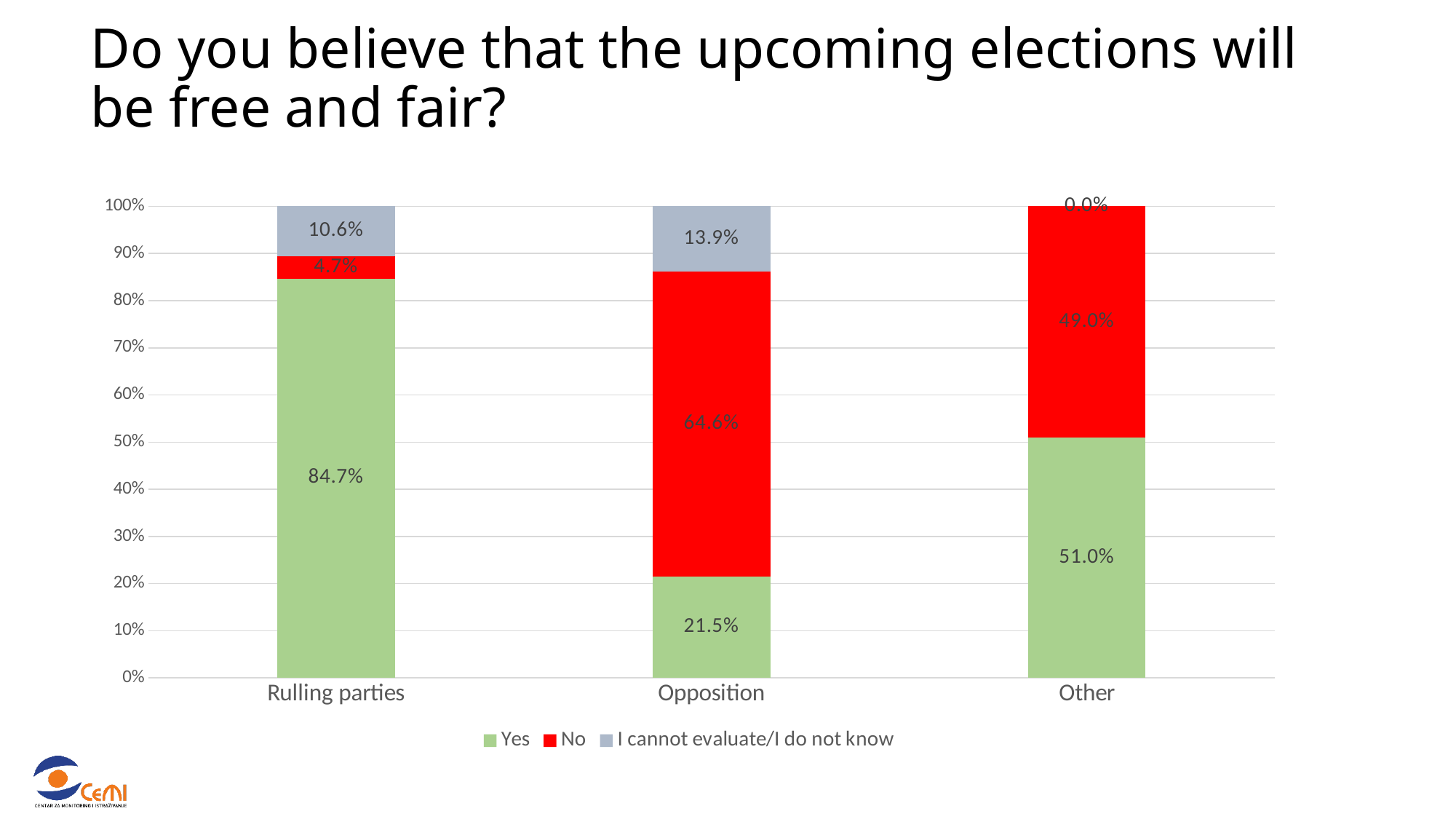
Which is larger: the No share for Opposition or the No share for Other? Opposition Which category has the lowest No share? Rulling parties What percentage of Opposition respondents answered No? 64.6% How many series does the legend list? 3 What percentage of Other respondents answered No? 49.0% What kind of chart is shown on the slide? Stacked bar chart Which category has the highest Yes share? Rulling parties Which colour represents the 'No' series? Red What percentage of Rulling parties respondents answered Yes? 84.7% How many categories are shown on the x axis? 3 What is the value for 'I cannot evaluate/I do not know' in the Opposition category? 13.9% What is the difference between the Yes share for Rulling parties and the Yes share for Opposition? 63.2%